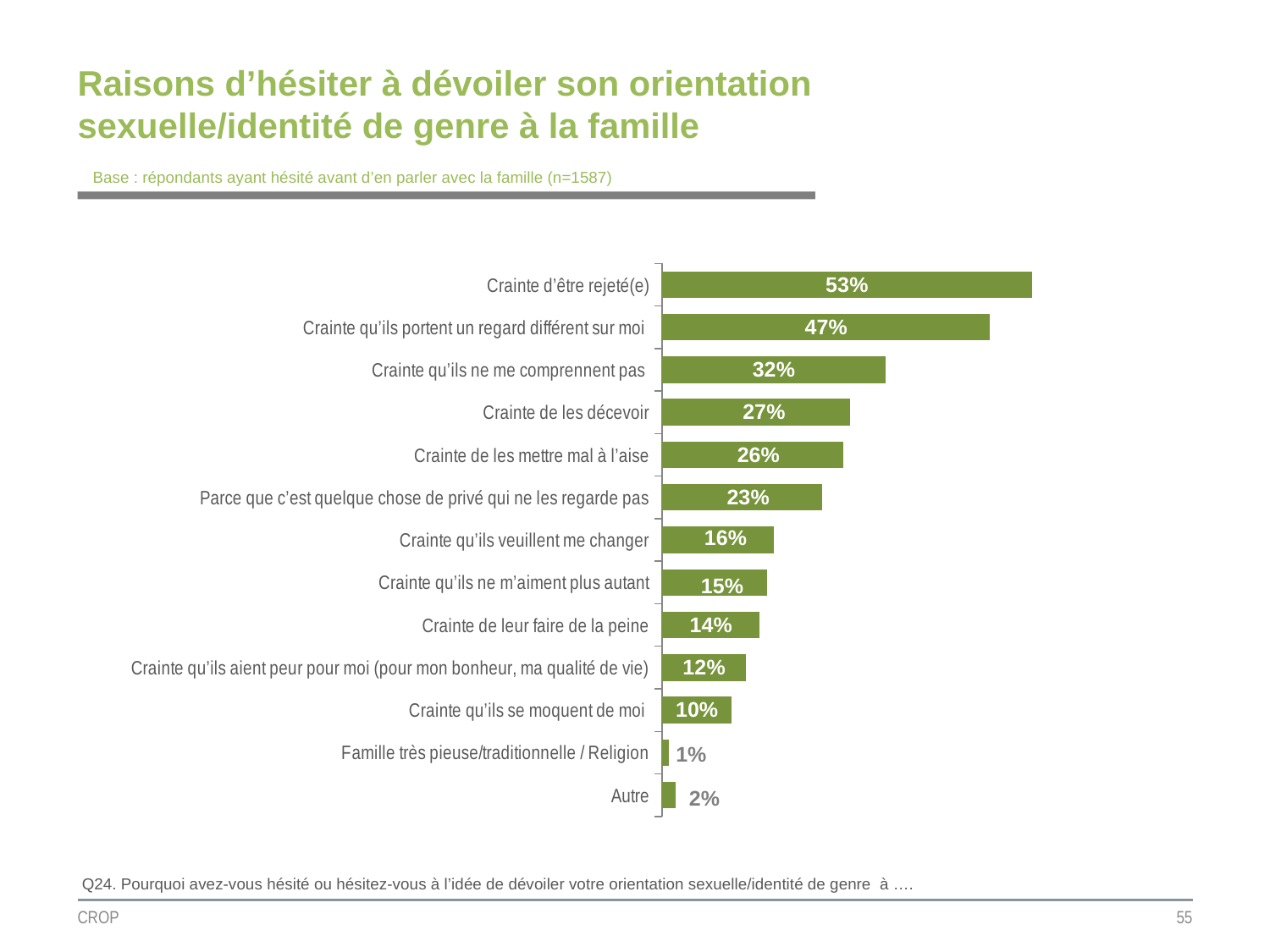
Which category has the highest value? Crainte d'être rejeté(e) What is the difference between "Crainte d'être rejeté(e)" and "Crainte qu'ils portent un regard différent sur moi"? 6% What kind of chart is shown on the slide? Bar chart What is the value for "Crainte d'être rejeté(e)"? 53% What is the difference between "Crainte qu'ils veuillent me changer" and "Crainte qu'ils aient peur pour moi (pour mon bonheur, ma qualité de vie)"? 4% What is the value for "Crainte qu'ils ne me comprennent pas"? 32% What is the base size (n) stated for the chart? n=1587 What is the value for "Autre"? 2% Which category has the lowest value? Famille très pieuse/traditionnelle / Religion What is the value for "Crainte qu'ils se moquent de moi"? 10% How many categories are shown in the chart? 13 Which is larger: "Crainte de les décevoir" or "Crainte de les mettre mal à l'aise"? Crainte de les décevoir